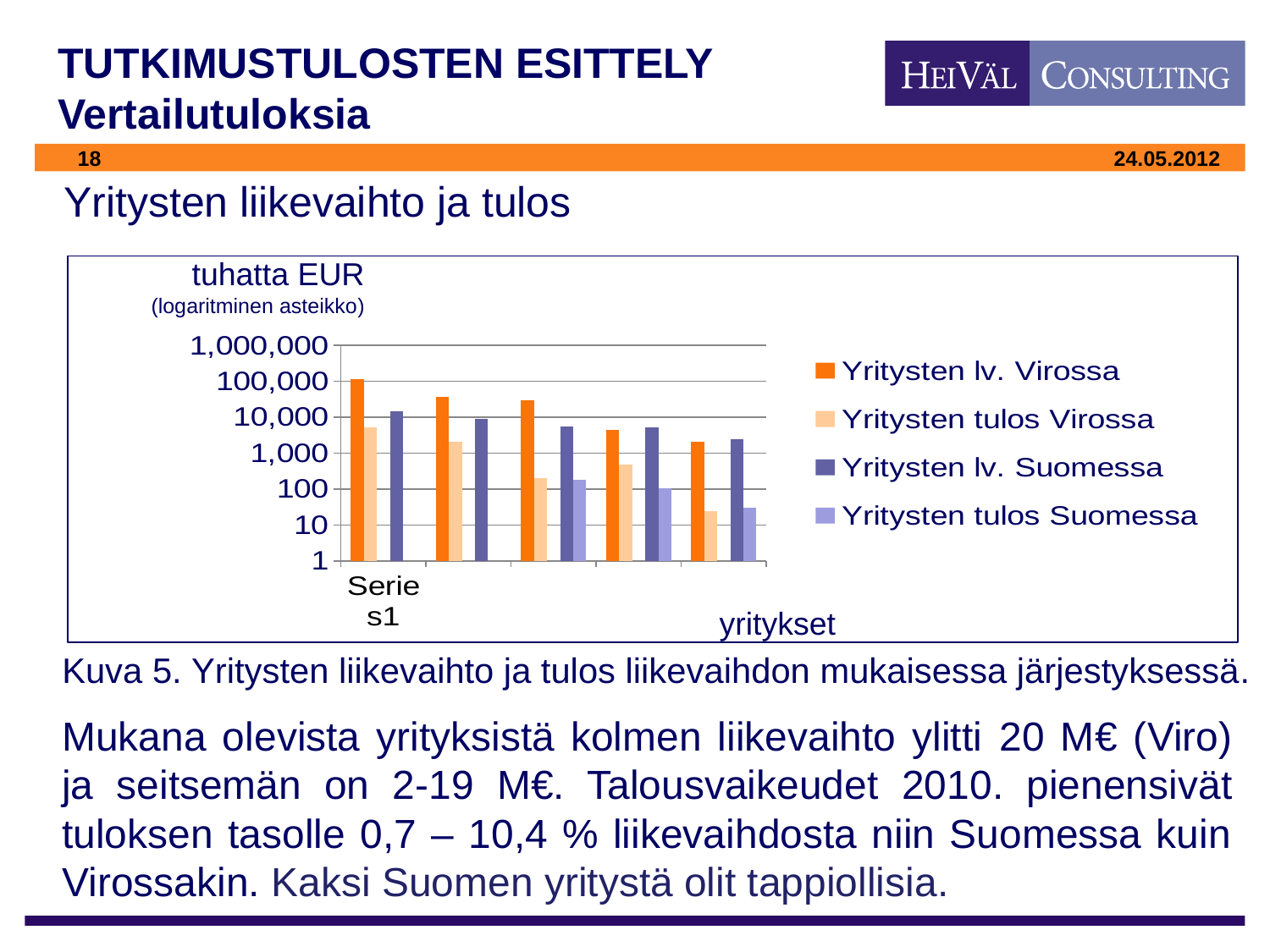
How many series does the chart legend list? 4 Is the value for Yritysten lv. Virossa in Series1 greater or less than 10,000? greater Which series is shown in orange in the legend? Yritysten lv. Virossa Do the values for Yritysten lv. Virossa rise or fall from left to right along the x axis? fall Which series has the highest bar in Series1? Yritysten lv. Virossa Is the value for Yritysten tulos Virossa in Series1 greater or less than 1,000? greater What kind of chart is shown on the slide? bar chart In Series1, which is larger: Yritysten lv. Virossa or Yritysten lv. Suomessa? Yritysten lv. Virossa What unit is given on the vertical axis of the chart? tuhatta EUR Is the value for Yritysten lv. Suomessa in Series1 greater or less than 10,000? greater How many groups of bars are plotted along the x axis? 5